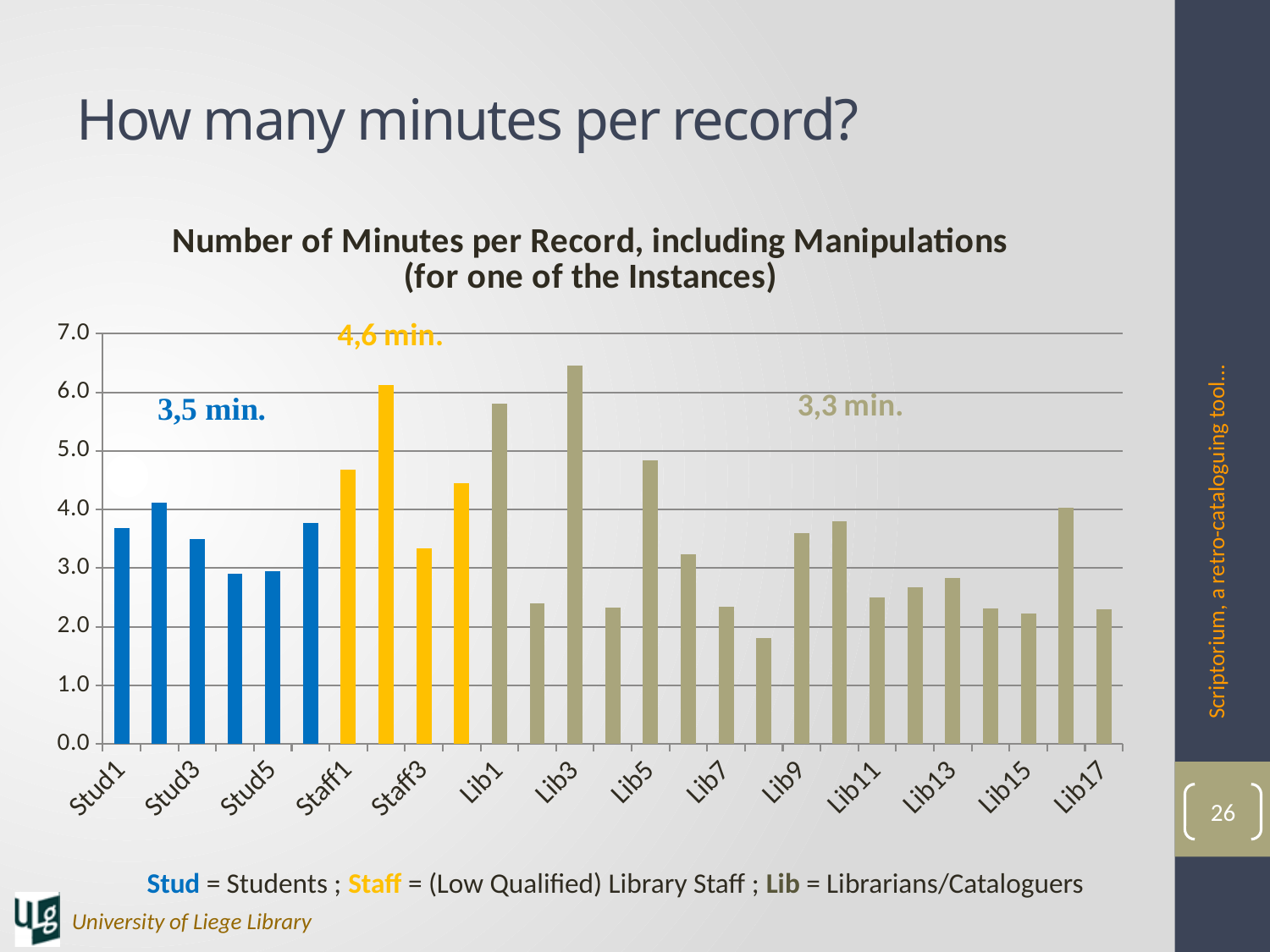
What kind of chart is shown on the slide? bar chart Which category has the highest number of minutes per record? Lib3 What is the title of the chart? Number of Minutes per Record, including Manipulations (for one of the Instances) What average number of minutes is annotated above the Staff group of bars? 4,6 min. Which is larger, the value for Lib1 or the value for Lib2? Lib1 Is the value for Lib8 greater or less than 2.0? less Is the value for Lib1 greater or less than 5.0? greater How many bars are plotted in the chart? 27 Which is larger, the value for Staff1 or the value for Staff3? Staff1 Is the value for Lib4 greater or less than 3.0? less Which category has the lowest number of minutes per record? Lib8